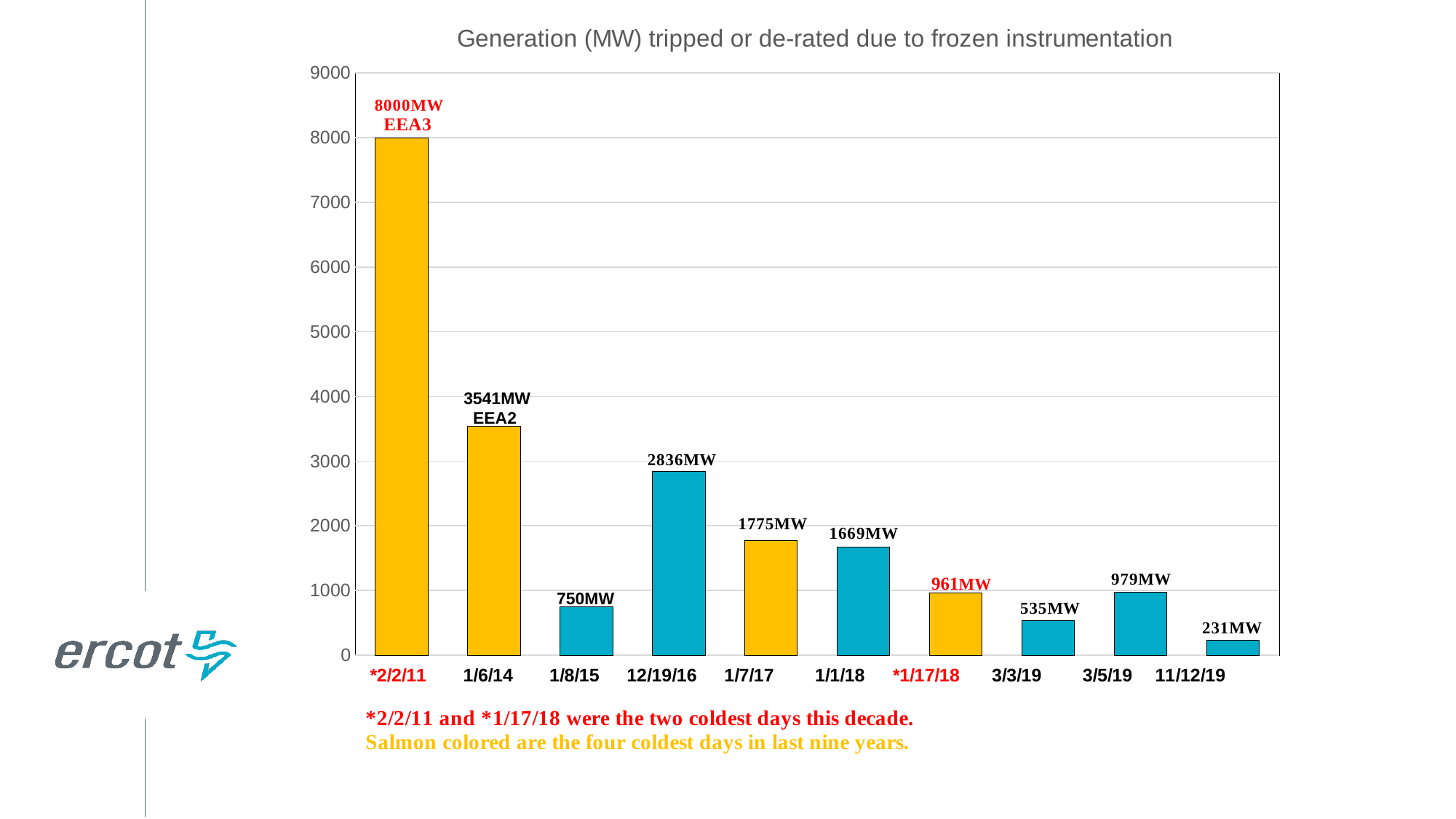
What value is shown for 1/1/18? 1669MW Is the value for 1/6/14 greater or less than 3000? greater What is the title of the chart? Generation (MW) tripped or de-rated due to frozen instrumentation Which date has the highest value? *2/2/11 Which date has the lowest value? 11/12/19 What kind of chart is this? bar chart How many dates are shown on the x axis? 10 What value is shown for 12/19/16? 2836MW What value is shown for 11/12/19? 231MW What is the difference between the values for 3/5/19 and 3/3/19? 444MW What is the difference between the values for 1/6/14 and 1/8/15? 2791MW Which is larger, the value for 1/7/17 or the value for 1/1/18? 1/7/17